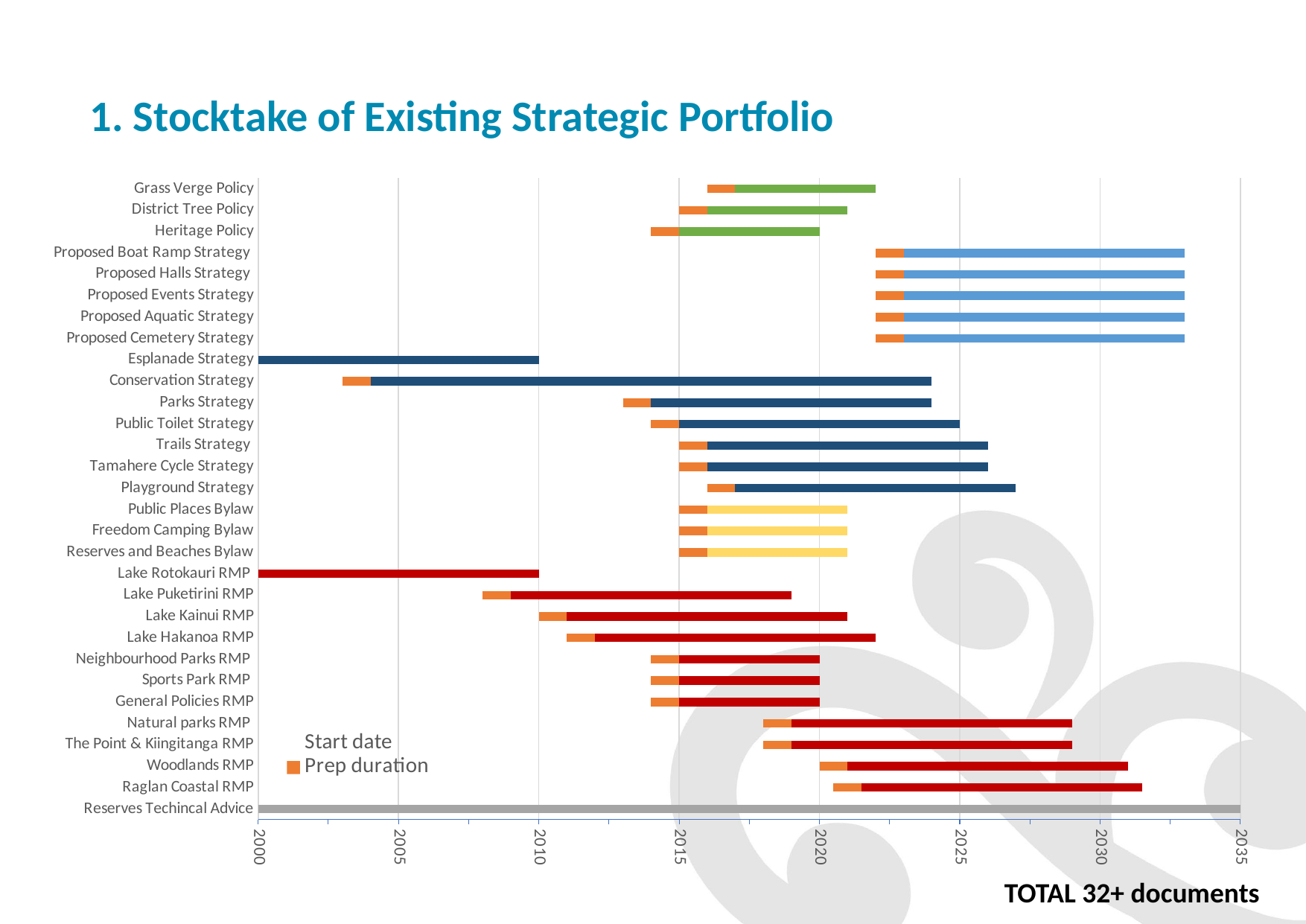
How many entries does the chart legend list? 2 Which bar ends later, Lake Puketirini RMP or Lake Hakanoa RMP? Lake Hakanoa RMP Does the Proposed Boat Ramp Strategy bar end after or before 2030? after What is the title of the slide containing the chart? 1. Stocktake of Existing Strategic Portfolio What kind of chart is shown on the slide? Bar chart In what year does the Public Toilet Strategy bar end? 2025 In what year does the Lake Rotokauri RMP bar end? 2010 What colour represents Prep duration in the chart legend? Orange Which document's bar extends furthest to the right on the chart? Reserves Techincal Advice How many documents (categories) are listed on the vertical axis of the chart? 30 In what year does the Esplanade Strategy bar end? 2010